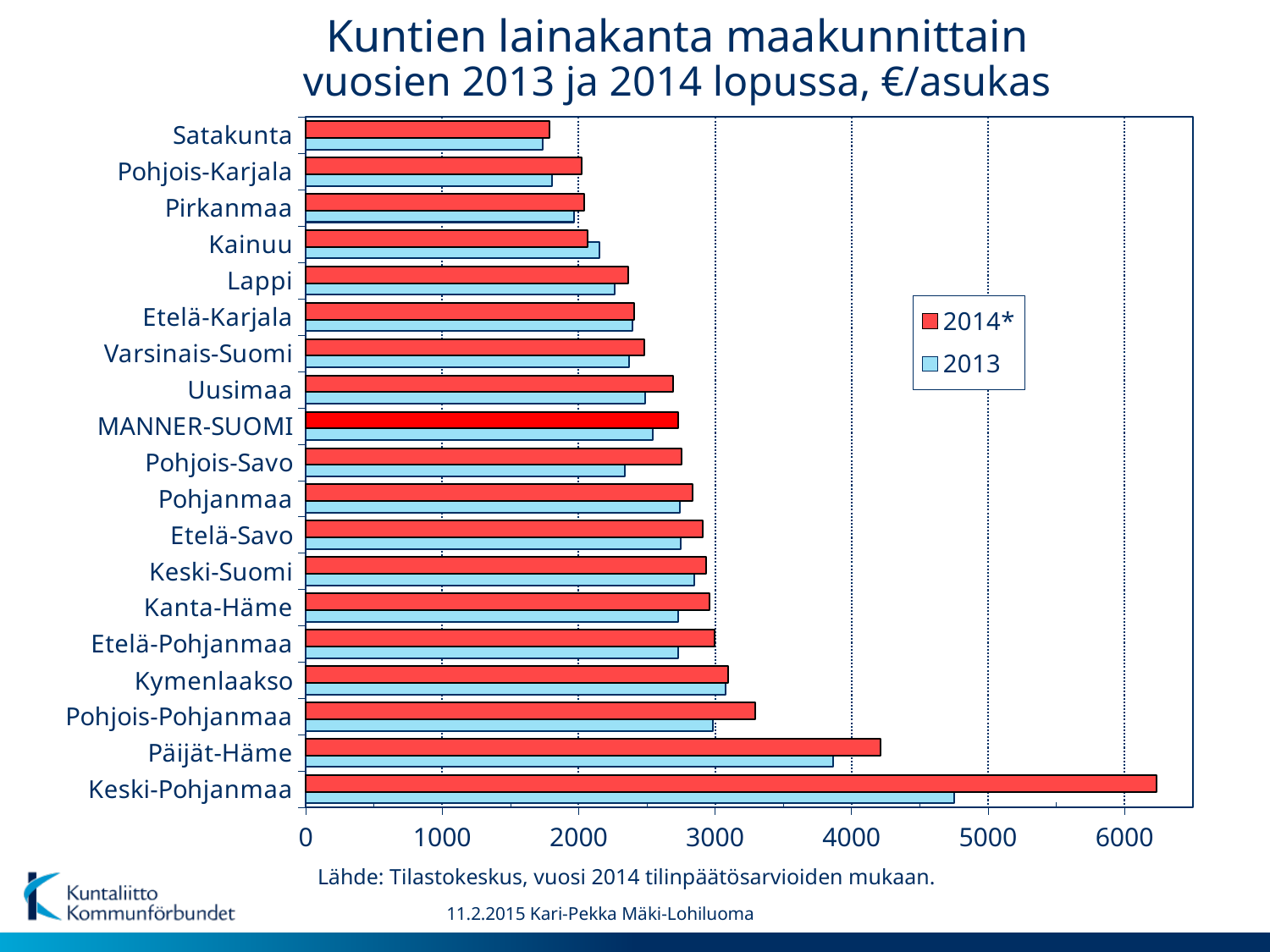
Which colour represents the 2013 series in the legend? light blue Which region has the highest 2013 value? Keski-Pohjanmaa Is the 2014* value for Uusimaa greater or less than 3000? less How many series does the legend list? 2 Is the 2014* value for Keski-Pohjanmaa greater or less than 6000? greater For Pohjois-Savo, which is larger: the 2014* value or the 2013 value? 2014* How many regions (categories) are shown on the chart? 19 What kind of chart is shown on the slide? bar chart Is the 2014* value for Pohjois-Pohjanmaa greater or less than 3000? greater Which region has the lowest 2014* value? Satakunta Which region has the highest 2014* value? Keski-Pohjanmaa